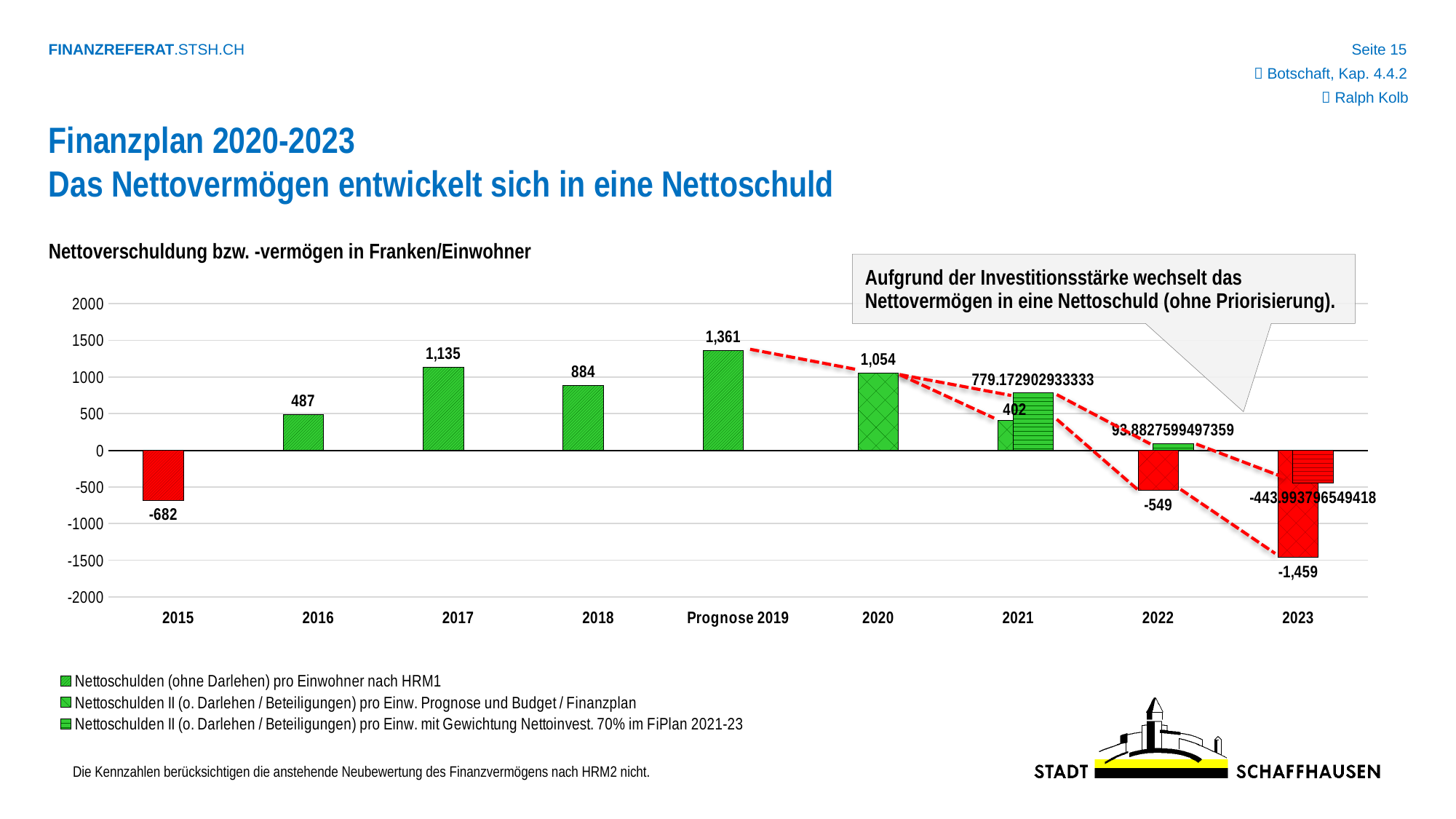
What is the value shown for 2017? 1,135 What is the difference between the values for Prognose 2019 and 2020? 307 What is the value shown for Prognose 2019? 1,361 Which category has the lowest value in the chart? 2023 What kind of chart is shown on the slide? bar chart How many year categories are shown on the x axis of the chart? 9 Which category has the highest value in the chart? Prognose 2019 What is the 2022 value for the series 'Nettoschulden II (o. Darlehen / Beteiligungen) pro Einw. mit Gewichtung Nettoinvest. 70% im FiPlan 2021-23'? 93.8827599497359 What is the difference between the values for 2017 and 2018? 251 How many series does the chart legend list? 3 Which is larger, the value for 2016 or the value for 2018? 2018 What is the value shown for 2015? -682